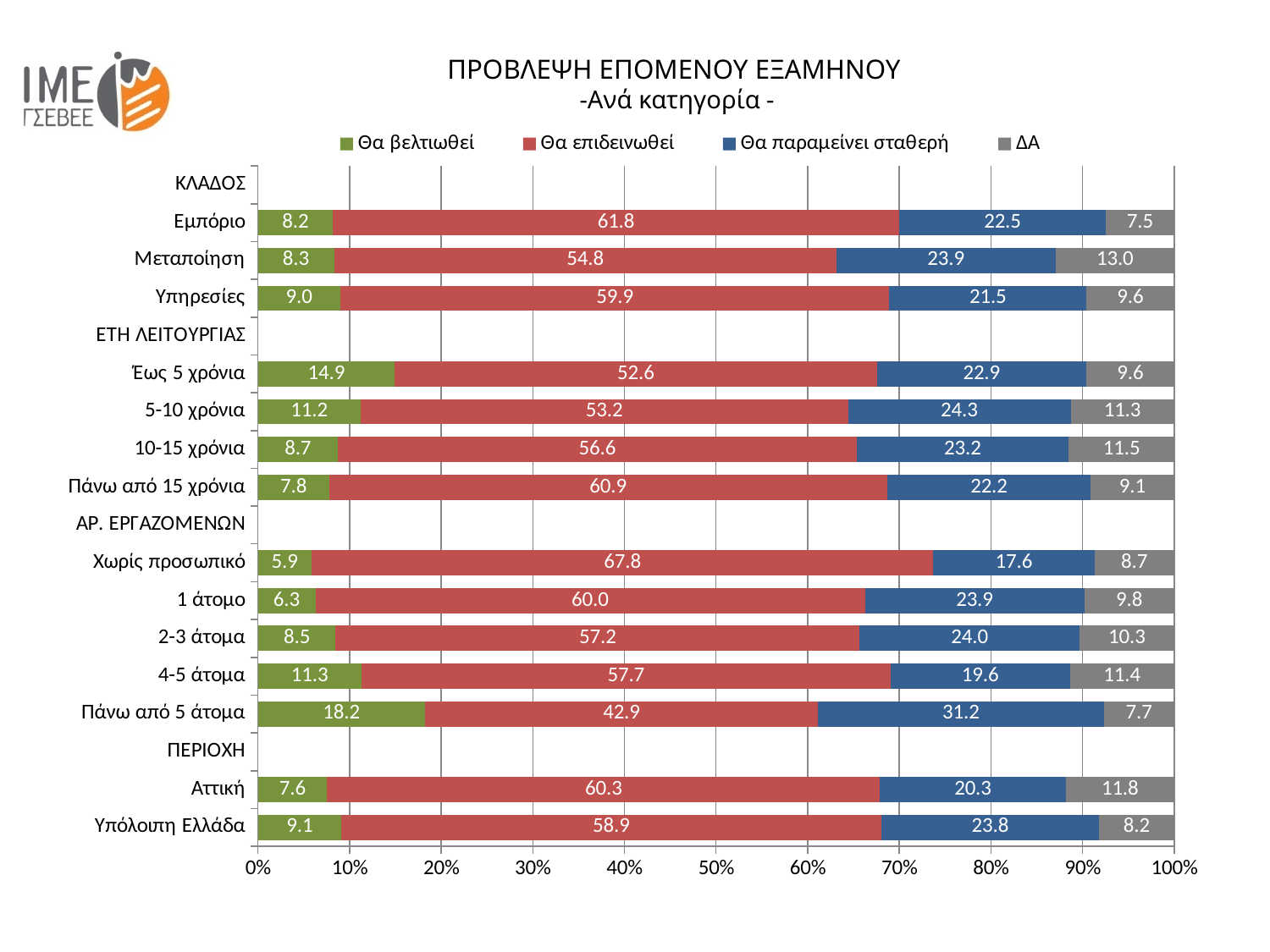
Which category has the lowest value for Θα επιδεινωθεί? Πάνω από 5 άτομα What is the value of Θα παραμείνει σταθερή for Πάνω από 5 άτομα? 31.2 How many series does the legend list? 4 What is the value of Θα επιδεινωθεί for Εμπόριο? 61.8 Which has the larger ΔΑ value, Αττική or Υπόλοιπη Ελλάδα? Αττική What type of chart is shown on the slide? Stacked bar chart What is the title of the chart? ΠΡΟΒΛΕΨΗ ΕΠΟΜΕΝΟΥ ΕΞΑΜΗΝΟΥ -Ανά κατηγορία - Which category has the highest value for Θα βελτιωθεί? Πάνω από 5 άτομα What is the difference between the Θα επιδεινωθεί values for Εμπόριο and Μεταποίηση? 7.0 Which category has the lowest value for Θα βελτιωθεί? Χωρίς προσωπικό What is the ΔΑ value for Μεταποίηση? 13.0 Which category has the highest value for Θα επιδεινωθεί? Χωρίς προσωπικό